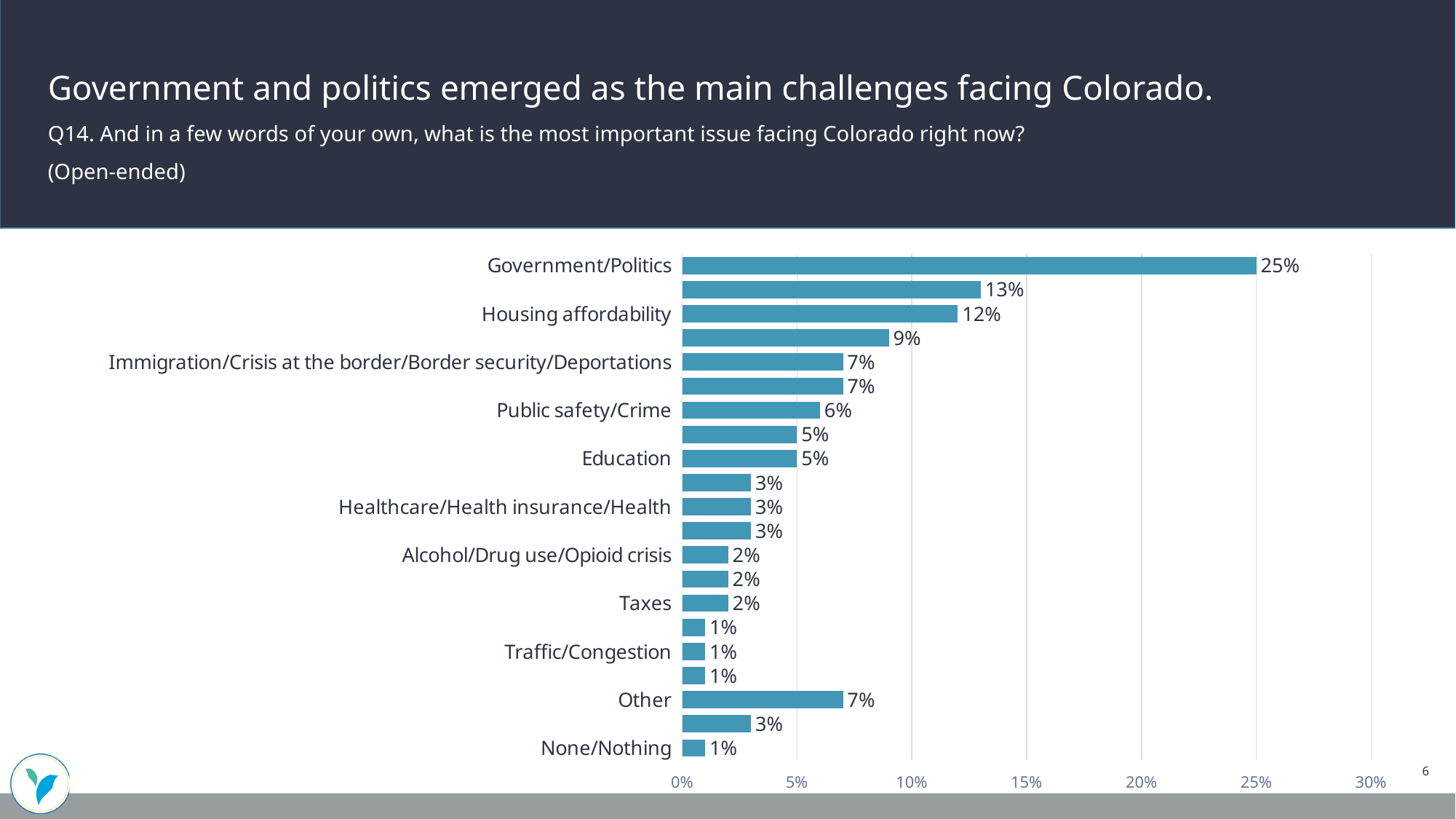
What percentage of respondents named Government/Politics as the most important issue facing Colorado? 25% What percentage is shown for Immigration/Crisis at the border/Border security/Deportations? 7% What is the difference between the values for Government/Politics and Housing affordability? 13% What is the value shown for Housing affordability? 12% What kind of chart is shown on the slide? Bar chart Is the value for Government/Politics greater or less than 20%? greater Which labeled category has the highest value on the chart? Government/Politics How many bars are plotted on the chart? 21 What percentage is shown for the Other category? 7% What is the highest value shown on the horizontal axis? 30% Which is larger, the value for Education or the value for Healthcare/Health insurance/Health? Education What is the value for Public safety/Crime? 6%